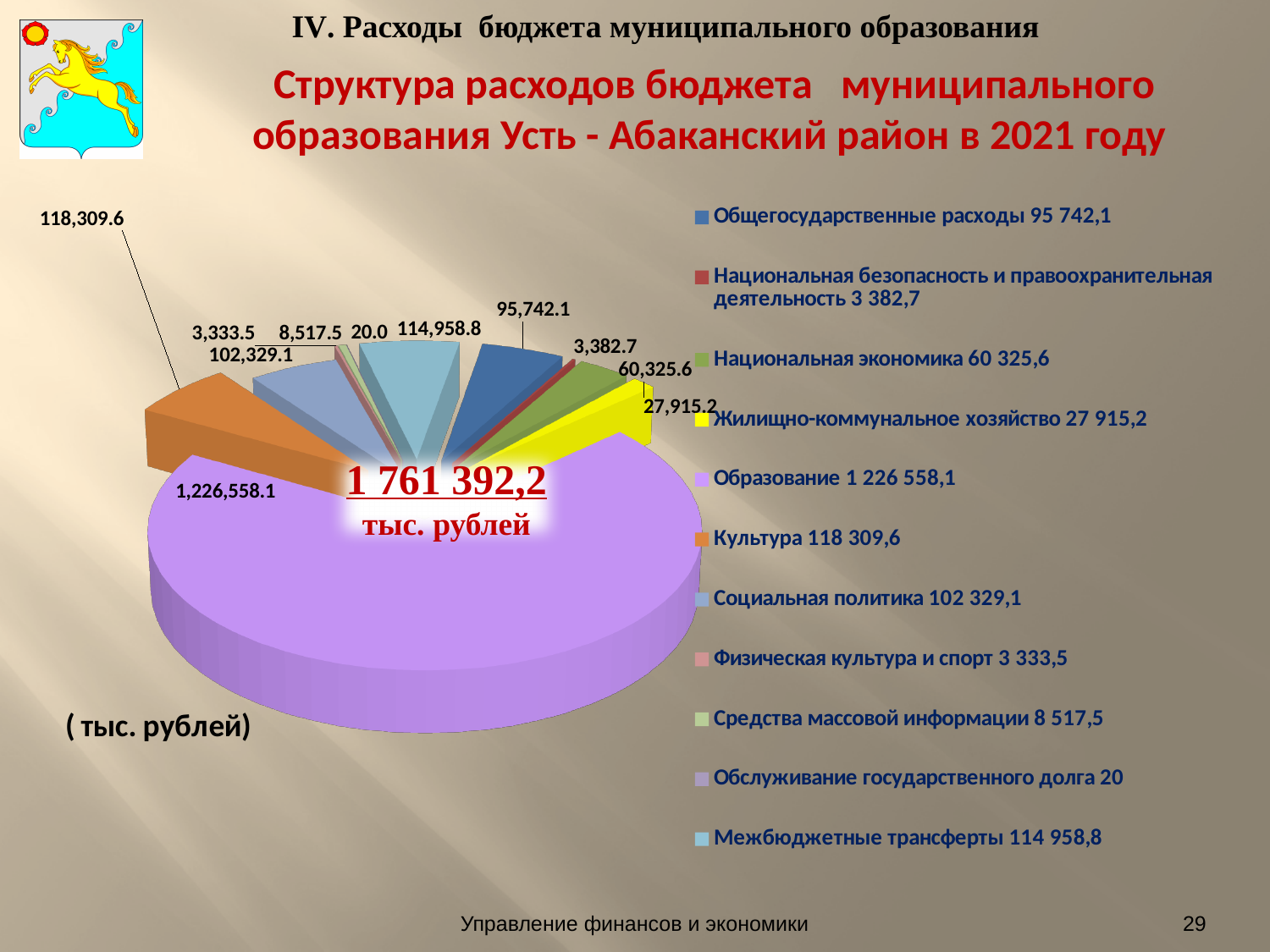
Which expenditure category has the smallest value in the pie chart? Обслуживание государственного долга What kind of chart is shown on the slide? Pie chart How many expenditure categories does the legend of the pie chart list? 11 Which is larger: Социальная политика or Межбюджетные трансферты? Межбюджетные трансферты Which expenditure category has the largest slice of the pie chart? Образование In what year are the budget expenditures shown in the chart title? 2021 What is the value for Межбюджетные трансферты in the pie chart? 114 958,8 What is the value for Культура in the pie chart? 118 309,6 What total amount of budget expenditures is shown in the centre of the pie chart? 1 761 392,2 тыс. рублей What is the value for Национальная экономика in the pie chart? 60 325,6 What is the difference between the values for Национальная экономика and Жилищно-коммунальное хозяйство? 32 410,4 Which is larger: Физическая культура и спорт or Национальная безопасность и правоохранительная деятельность? Национальная безопасность и правоохранительная деятельность